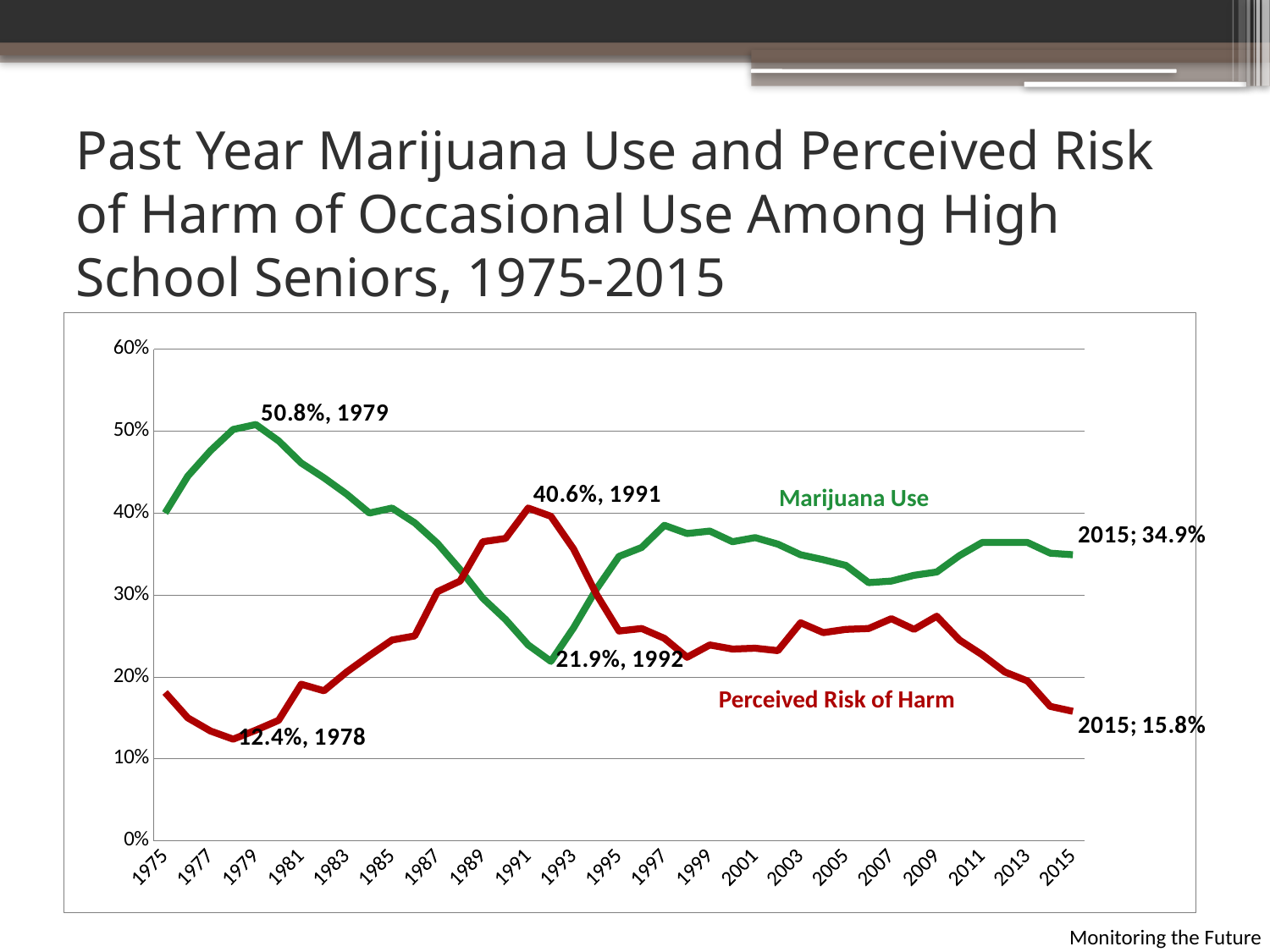
How many series does the chart show? 2 Is the Perceived Risk of Harm value for 2003 greater or less than 20%? greater What was the Perceived Risk of Harm value in 2015? 15.8% What was the Marijuana Use value in 1992? 21.9% What was the Marijuana Use value in 1979? 50.8% In which year was Perceived Risk of Harm at its lowest? 1978 What was the Perceived Risk of Harm value in 1978? 12.4% In which year did Marijuana Use reach its highest value? 1979 What was the Marijuana Use value in 2015? 34.9% What kind of chart is shown on the slide? Line chart What was the Perceived Risk of Harm value in 1991? 40.6% In 2015, how much higher was Marijuana Use than Perceived Risk of Harm? 19.1 percentage points